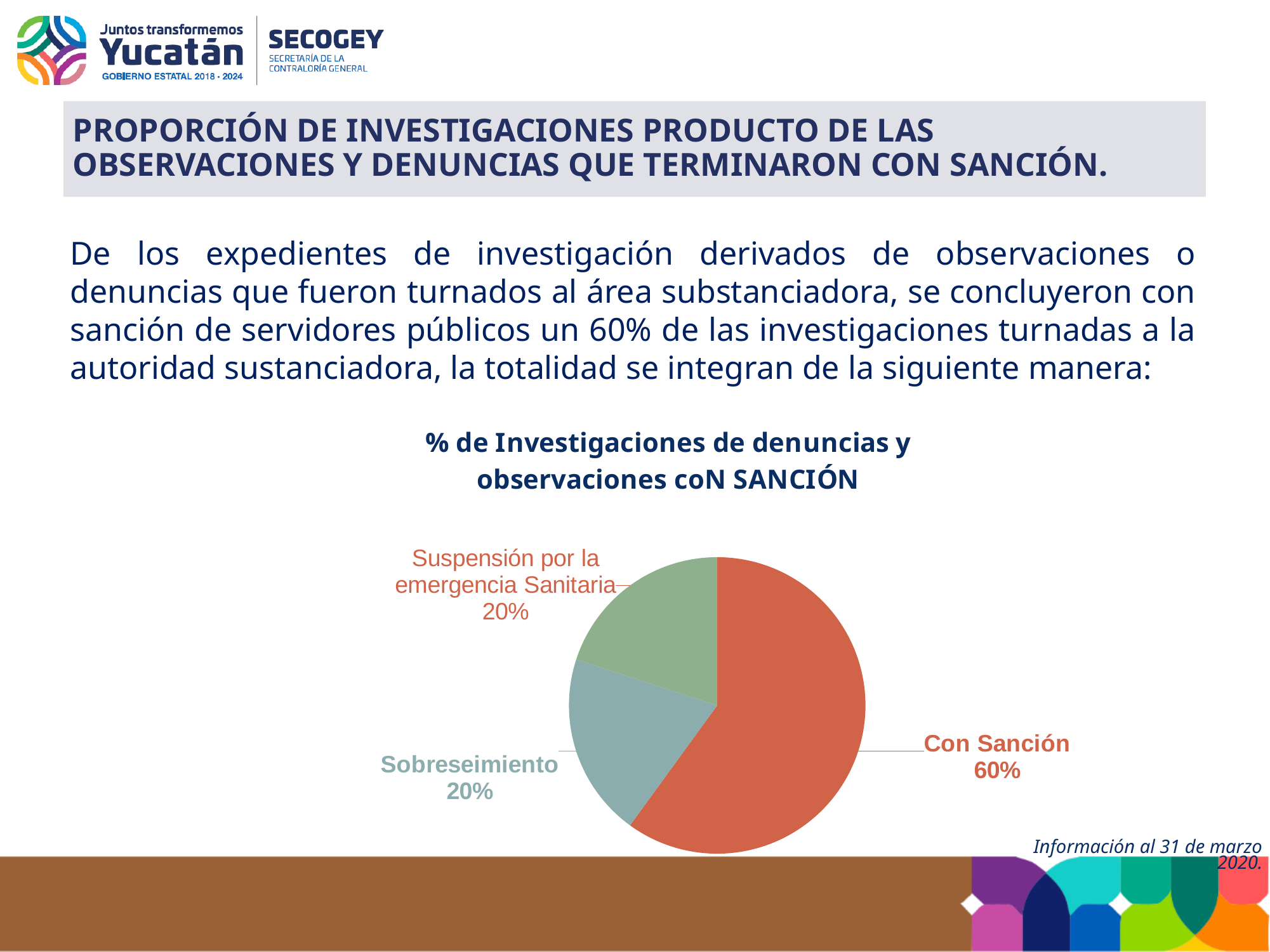
What is the value for Sobreseimiento? 20% What share of the pie do Sobreseimiento and Suspensión por la emergencia Sanitaria make up together? 40% Which is larger, Con Sanción or Suspensión por la emergencia Sanitaria? Con Sanción Is the value for Con Sanción greater or less than 50%? greater What is the difference between the Con Sanción share and the Sobreseimiento share? 40% What is the value for Suspensión por la emergencia Sanitaria? 20% What is the title of the pie chart? % de Investigaciones de denuncias y observaciones coN SANCIÓN What is the value for Con Sanción? 60% Which category has the largest share of the pie? Con Sanción What colour is the Con Sanción slice? Red/orange How many slices does the pie chart have? 3 What kind of chart is shown on the slide? Pie chart